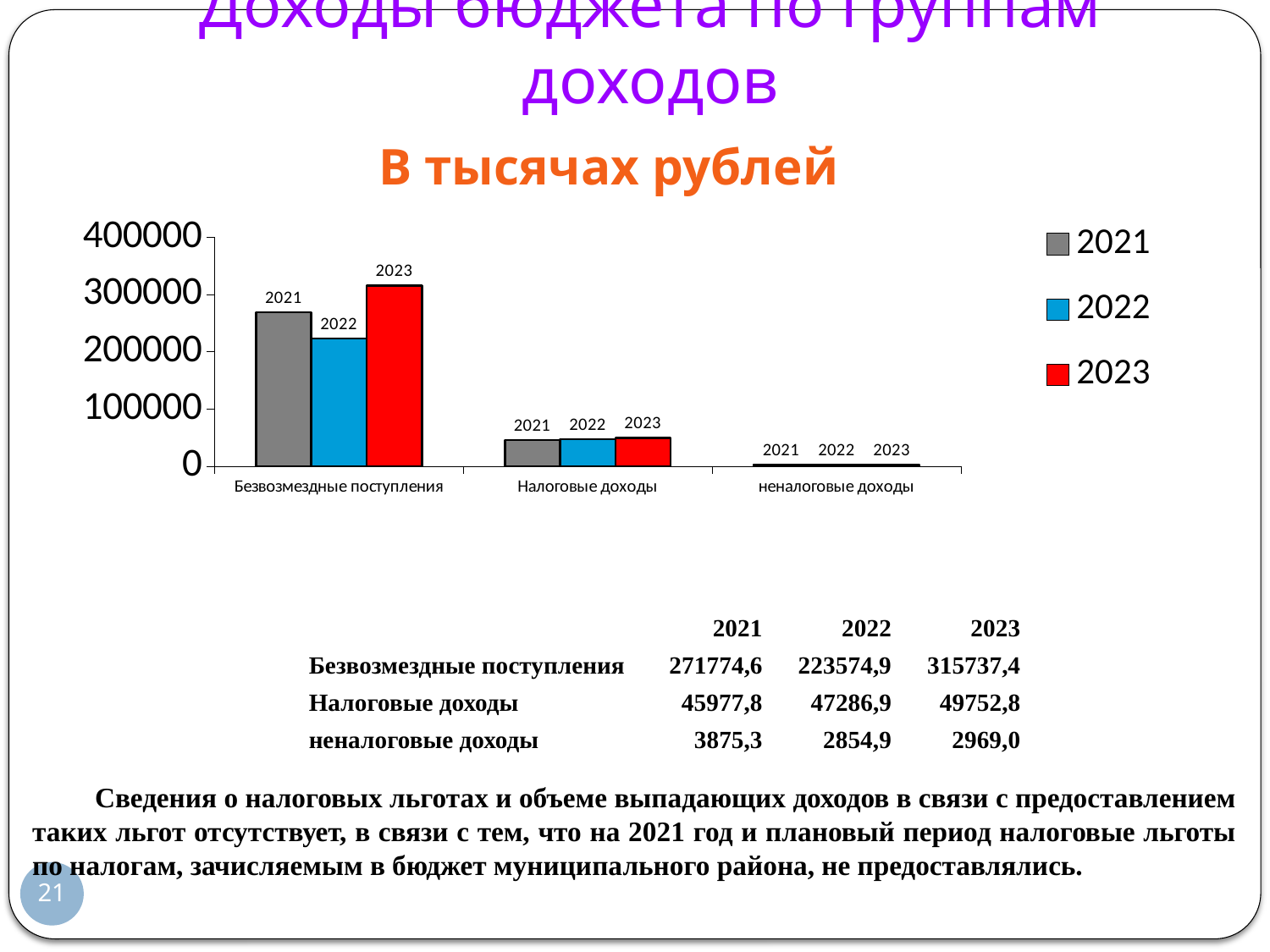
Which category has the lowest value in 2021? неналоговые доходы What is the value for Налоговые доходы in 2022? 47286,9 What is the value for Безвозмездные поступления in 2023? 315737,4 Is the value for Безвозмездные поступления in 2023 greater or less than 300000? greater What is the value for неналоговые доходы in 2021? 3875,3 Which is larger for Безвозмездные поступления: the 2021 value or the 2022 value? 2021 How many series does the chart legend list? 3 Do the values for Налоговые доходы rise or fall from 2021 to 2023? rise What kind of chart is shown on the slide? bar chart Which category has the highest value in 2023? Безвозмездные поступления What is the difference between the 2023 and 2022 values for Безвозмездные поступления? 92162,5 How many categories are shown on the x axis of the chart? 3